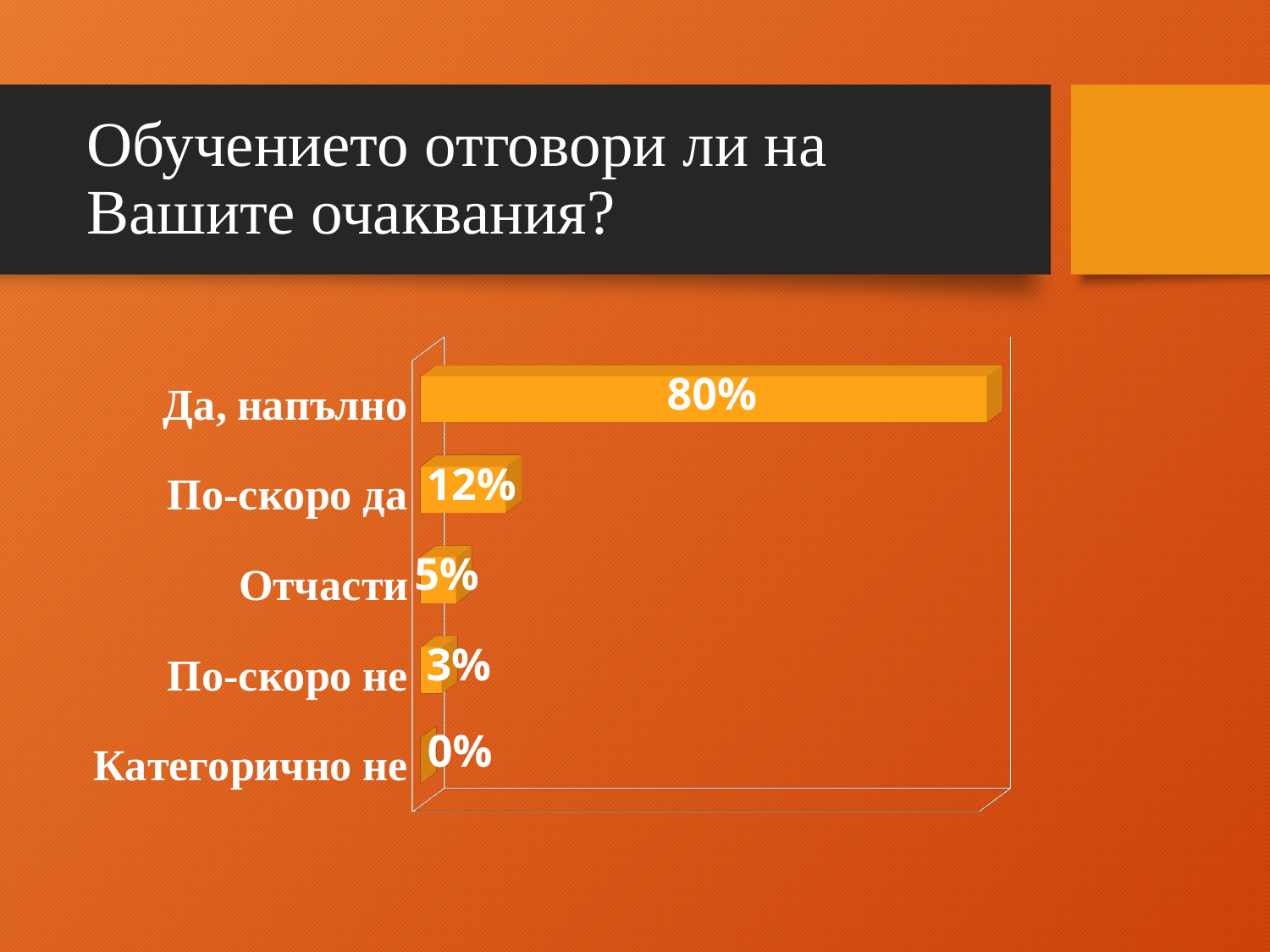
What is the difference between the values for "Отчасти" and "По-скоро не"? 2% Which is larger, the value for "По-скоро да" or the value for "Отчасти"? По-скоро да What is the value for "По-скоро да"? 12% Which category has the lowest value? Категорично не What is the difference between the values for "Да, напълно" and "По-скоро да"? 68% What is the value for "Категорично не"? 0% Which category has the highest value? Да, напълно How many categories are shown in the chart? 5 What is the value for "Да, напълно"? 80% What is the value for "По-скоро не"? 3% What is the value for "Отчасти"? 5% What kind of chart is shown on the slide? Bar chart